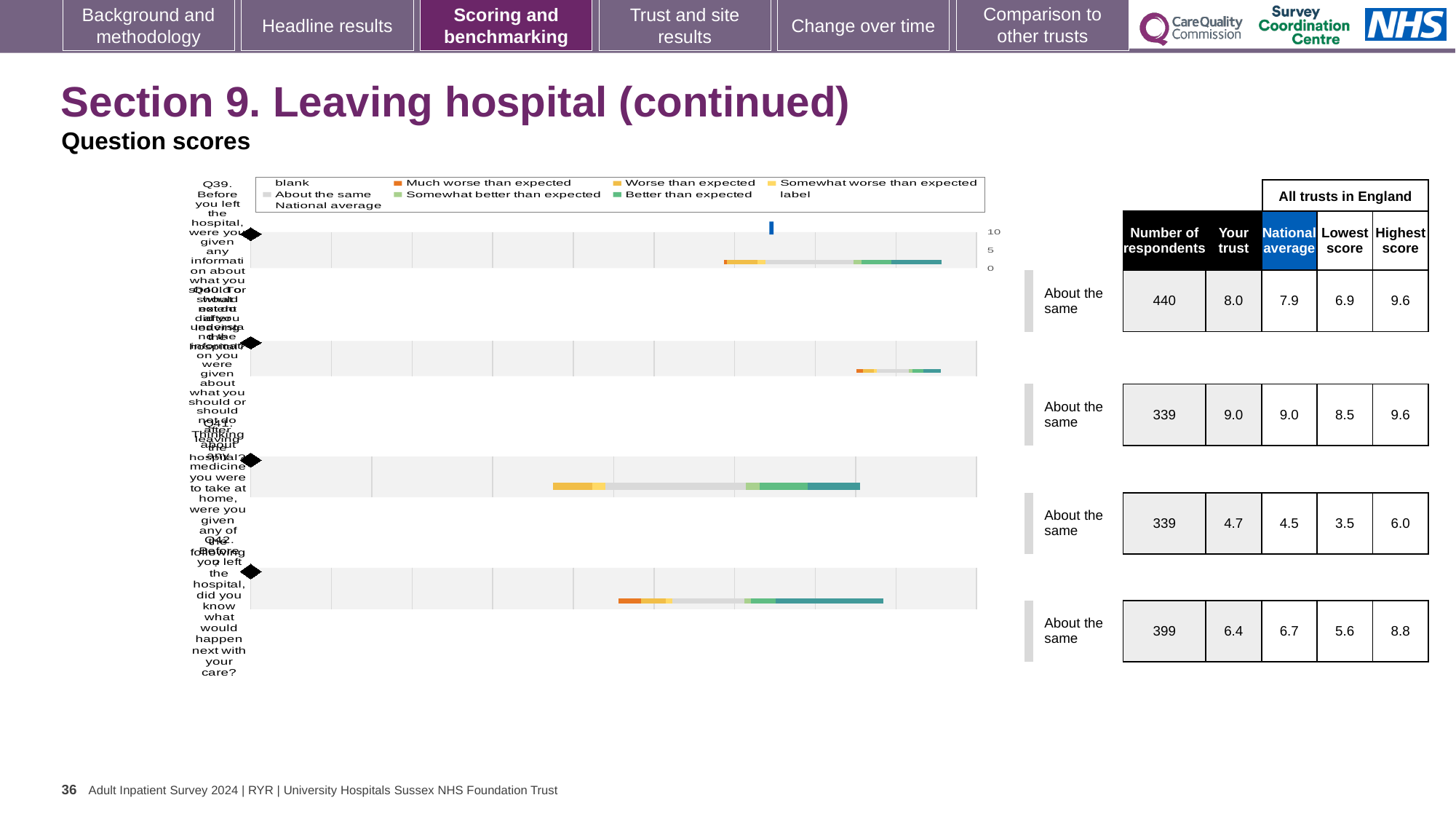
In the legend, which entry is shown in orange? Much worse than expected In the table, what is the highest score for the third row (Q41)? 6.0 Which row in the table has the lowest 'Your trust' score? the third row (Q41), 4.7 For the top row (Q39), is the 'Your trust' score or the national average larger? Your trust (8.0) What kind of chart is used for the question scores on this slide? bar chart In the table, what is the national average for the bottom row (Q42)? 6.7 In the table, what is the number of respondents for the top row (Q39)? 440 How many question charts (Q39 to Q42) are shown on the slide? 4 In the table, what is the lowest score for the second row (Q40)? 8.5 In the table, what is the 'Your trust' score for the top row (Q39)? 8.0 Which row in the table has the highest 'Your trust' score? the second row (Q40), 9.0 What is the difference between the 'Your trust' score and the national average for the bottom row (Q42)? 0.3